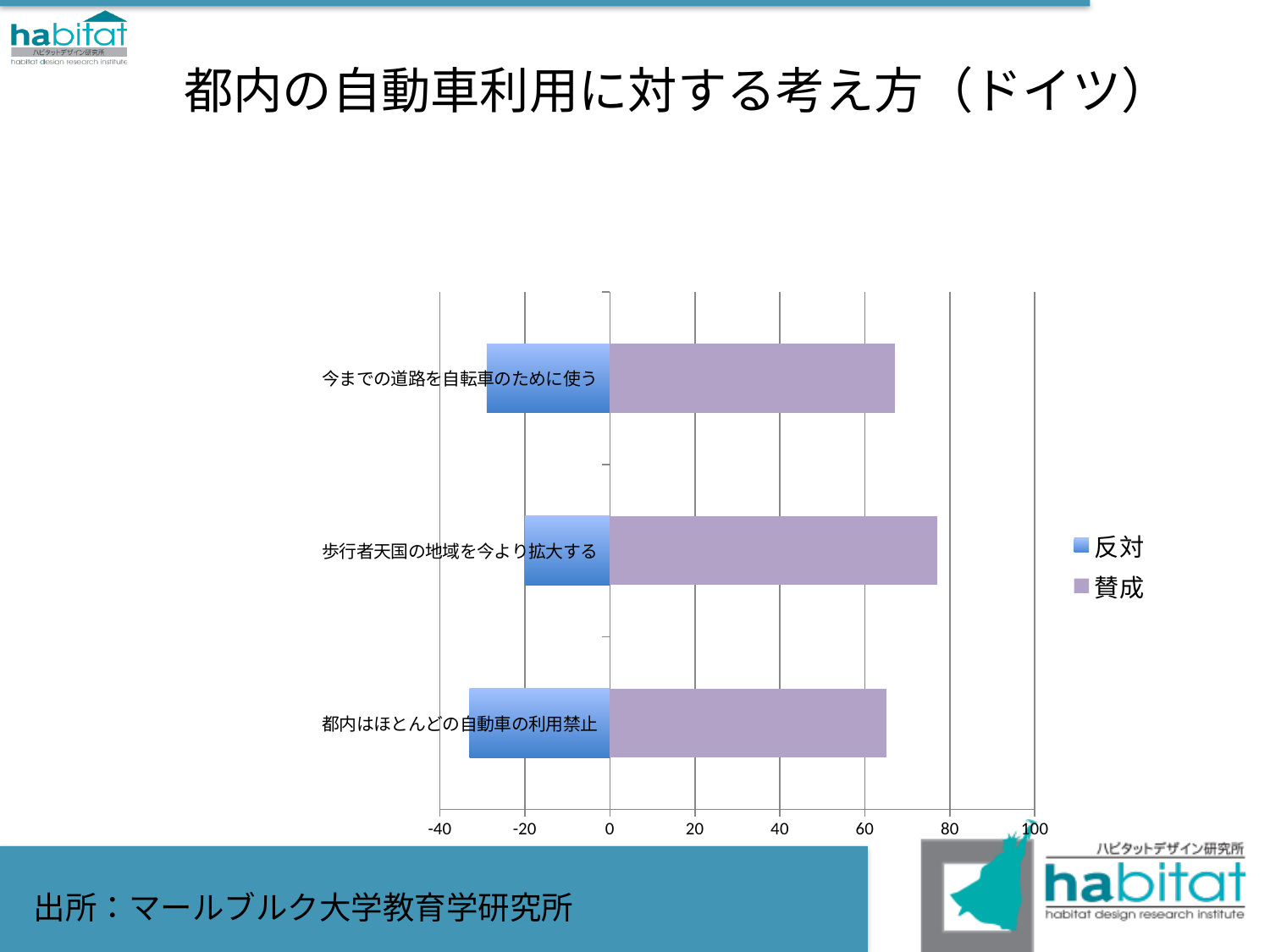
Is the 賛成 value for 歩行者天国の地域を今より拡大する greater or less than 80? less Which category has the highest 賛成 value? 歩行者天国の地域を今より拡大する What is the title of the slide containing the chart? 都内の自動車利用に対する考え方（ドイツ） How many series does the legend list? 2 How many categories are plotted in the chart? 3 Which has the larger 賛成 value: 歩行者天国の地域を今より拡大する or 今までの道路を自転車のために使う? 歩行者天国の地域を今より拡大する What are the two series named in the legend? 反対 and 賛成 Which category has the shortest 反対 bar (closest to 0)? 歩行者天国の地域を今より拡大する Is the 賛成 value for 今までの道路を自転車のために使う greater or less than 60? greater Which category has the longest 反対 bar (most negative value)? 都内はほとんどの自動車の利用禁止 What kind of chart is shown on the slide? bar chart Is the 反対 value for 都内はほとんどの自動車の利用禁止 greater or less than -20? less